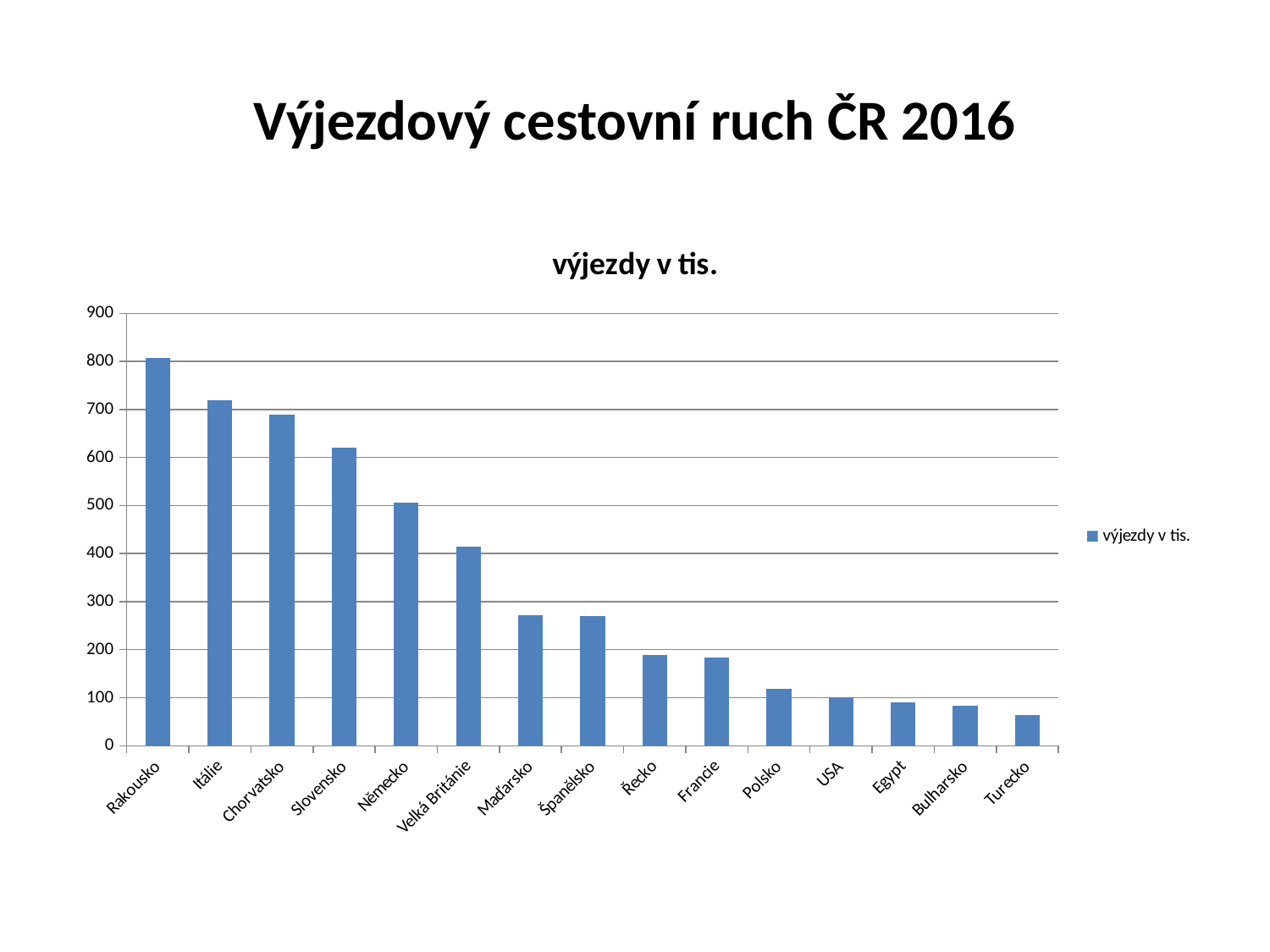
Which country has the highest value in the chart? Rakousko Is the value for Slovensko greater or less than 600? greater Which has a larger value, Itálie or Německo? Itálie Is the value for Velká Británie greater or less than 400? greater How many countries are shown on the x axis of the chart? 15 Is the value for Egypt greater or less than 100? less What kind of chart is shown on the slide? bar chart Do the values generally rise or fall from left to right along the x axis? fall Which country has the lowest value in the chart? Turecko How many series does the legend list? 1